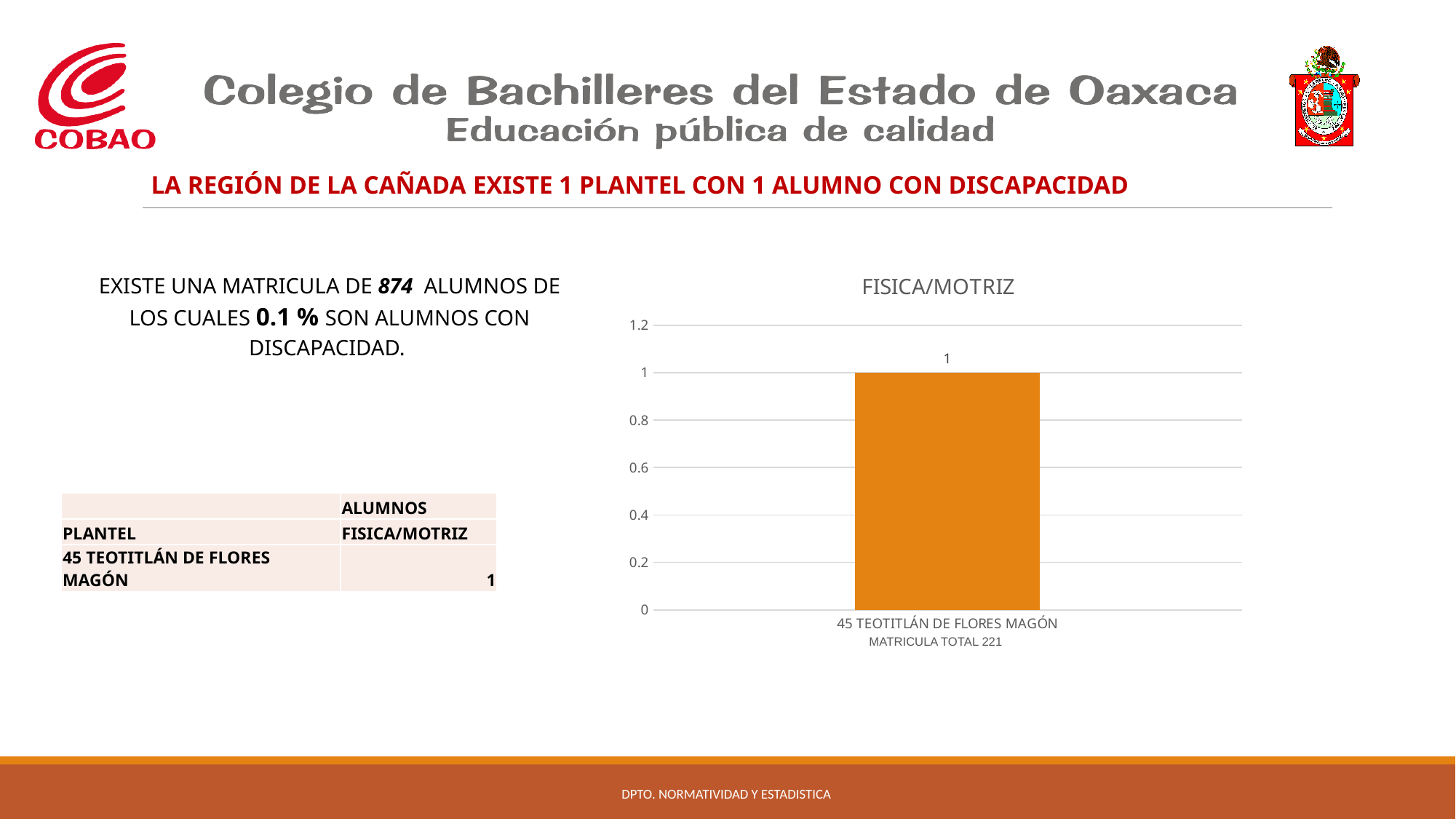
What is the value for 45 TEOTITLÁN DE FLORES MAGÓN in the FISICA/MOTRIZ chart? 1 What is the title of the chart? FISICA/MOTRIZ How many categories are plotted in the FISICA/MOTRIZ chart? 1 What is the category label on the x axis of the chart? 45 TEOTITLÁN DE FLORES MAGÓN What kind of chart is shown on the slide? bar chart Is the value for 45 TEOTITLÁN DE FLORES MAGÓN greater or less than 0.8? greater What is the highest value shown on the y axis of the chart? 1.2 Is the value for 45 TEOTITLÁN DE FLORES MAGÓN greater or less than 1.2? less